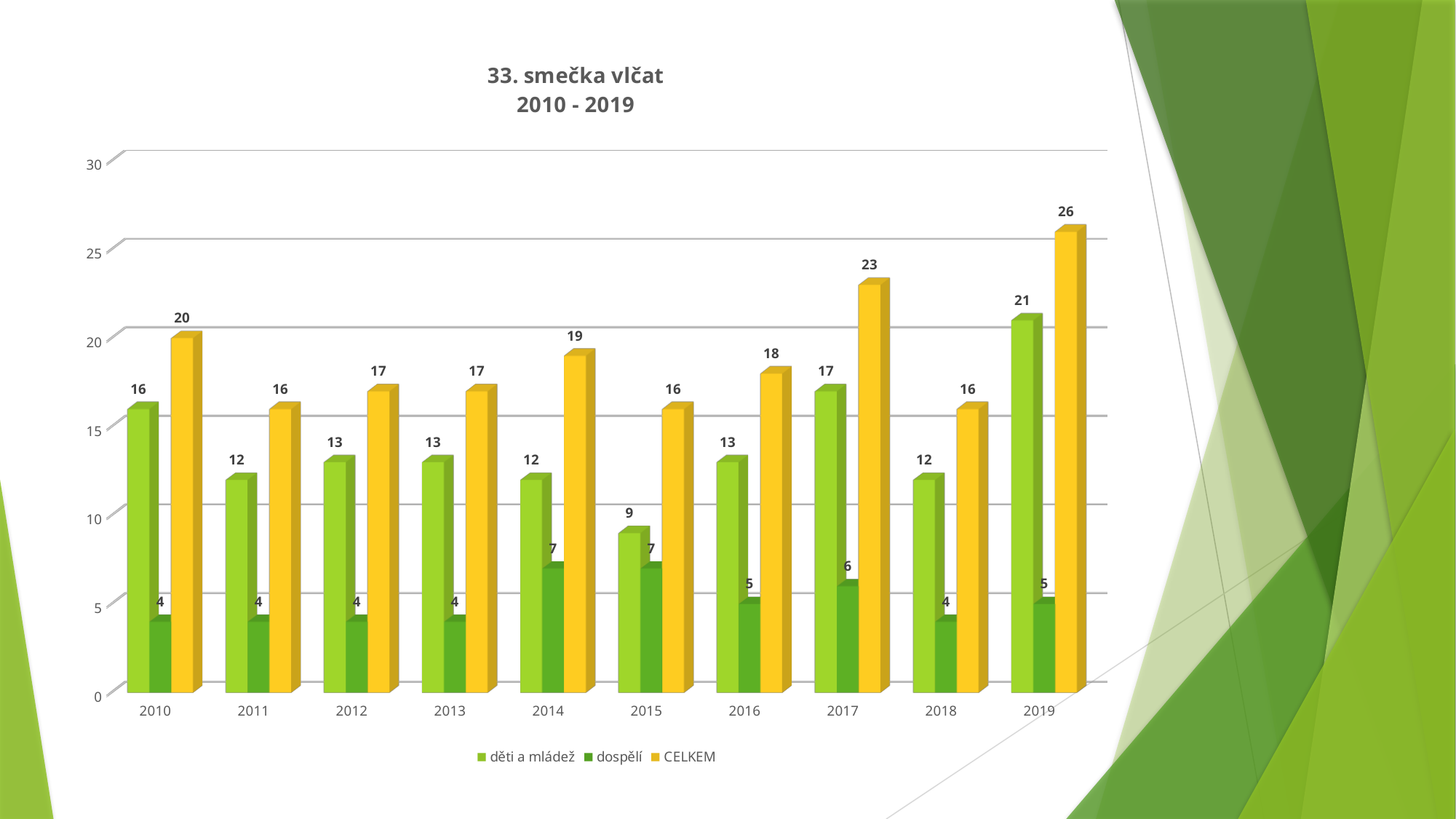
What is the title of the chart? 33. smečka vlčat 2010 - 2019 What is the value for CELKEM in 2019? 26 Which year has the lowest value for děti a mládež? 2015 What is the value for dospělí in 2017? 6 What kind of chart is shown on the slide? bar chart How many years are shown on the x axis? 10 How many series does the legend list? 3 What is the value for děti a mládež in 2015? 9 Which year has the highest CELKEM value? 2019 What is the difference between the CELKEM values for 2019 and 2018? 10 Which is larger, the děti a mládež value for 2017 or for 2016? 2017 Is the CELKEM value for 2017 greater or less than 20? greater